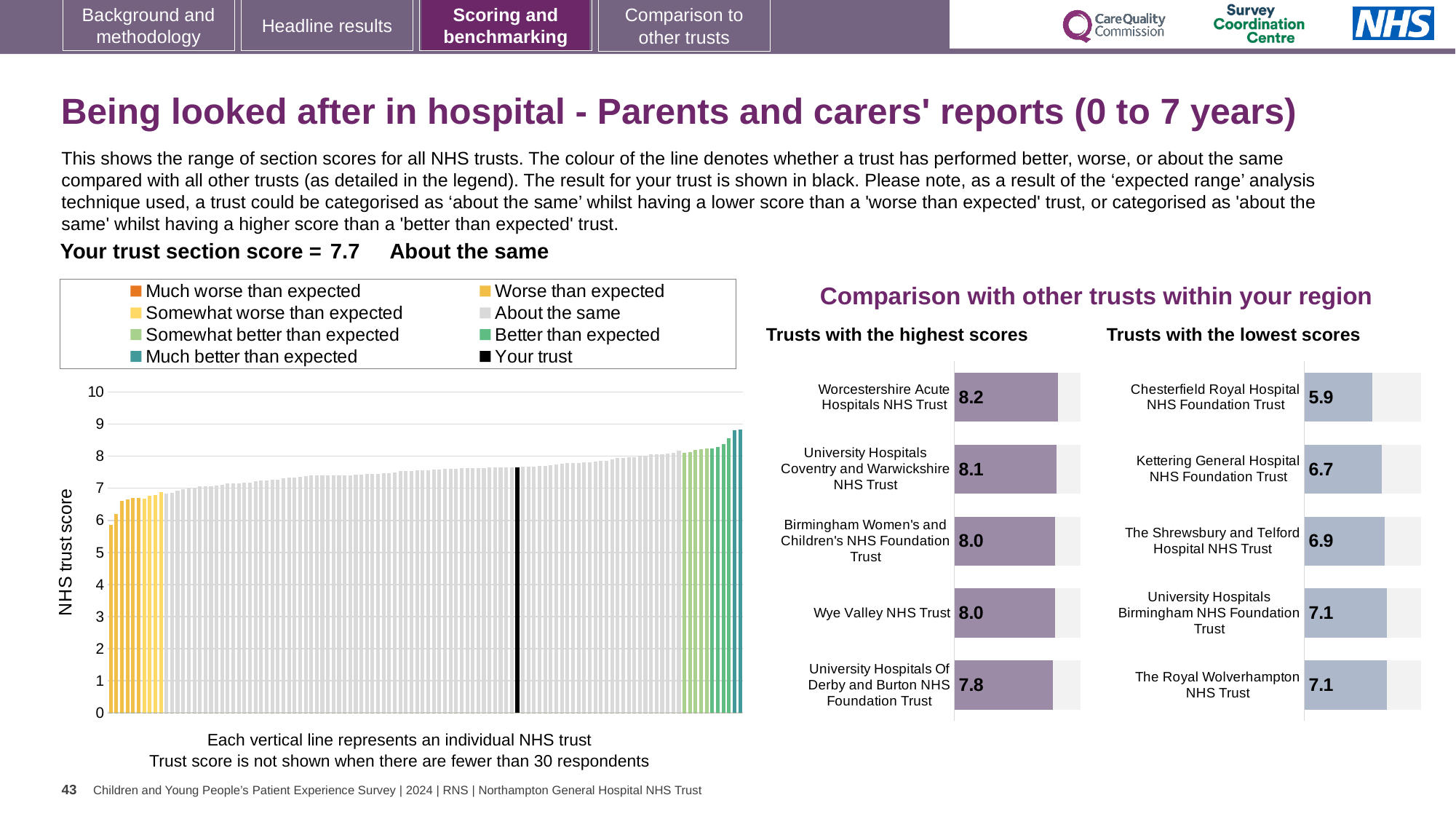
How many entries does the legend of the NHS trust score chart on the left list? 8 In the 'Trusts with the lowest scores' chart, what is the score for Kettering General Hospital NHS Foundation Trust? 6.7 In the NHS trust score chart on the left, what is the section score for your trust? 7.7 In the 'Trusts with the lowest scores' chart, which trust has the lowest score? Chesterfield Royal Hospital NHS Foundation Trust What kind of chart is the 'Trusts with the highest scores' chart? bar chart In the 'Trusts with the lowest scores' chart, which is larger: the score for The Shrewsbury and Telford Hospital NHS Trust or Kettering General Hospital NHS Foundation Trust? The Shrewsbury and Telford Hospital NHS Trust In the 'Trusts with the highest scores' chart, what is the difference between the scores of Worcestershire Acute Hospitals NHS Trust and University Hospitals Of Derby and Burton NHS Foundation Trust? 0.4 In the 'Trusts with the highest scores' chart, which trust has the lowest score? University Hospitals Of Derby and Burton NHS Foundation Trust In the 'Trusts with the highest scores' chart, how many trusts are shown? 5 In the 'Trusts with the highest scores' chart, what is the score for Worcestershire Acute Hospitals NHS Trust? 8.2 In the NHS trust score chart on the left, do the trust scores rise or fall from left to right? rise In the 'Trusts with the lowest scores' chart, what is the difference between the scores of Kettering General Hospital NHS Foundation Trust and Chesterfield Royal Hospital NHS Foundation Trust? 0.8